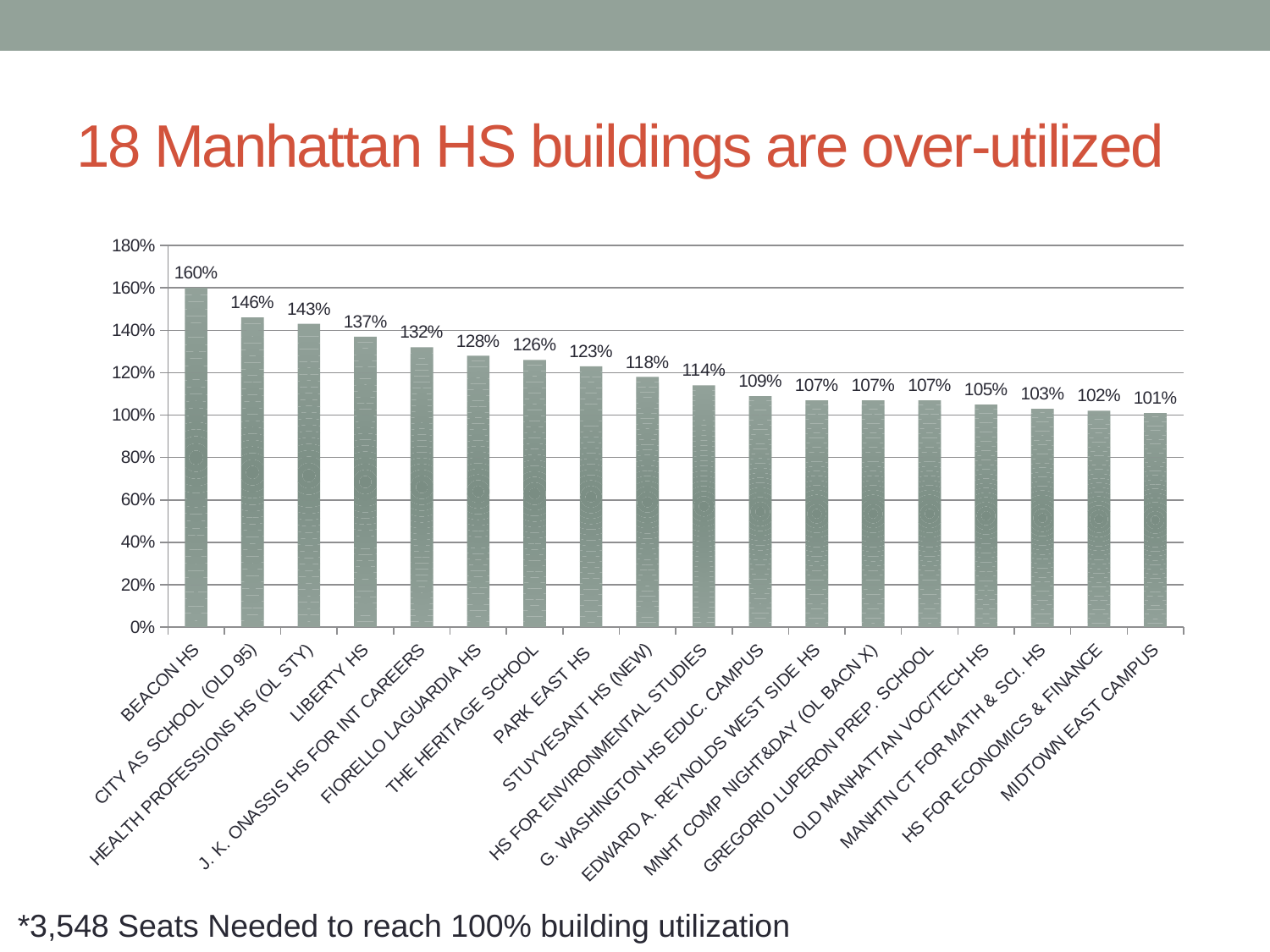
What is the utilization value shown for STUYVESANT HS (NEW)? 118% Which has a higher utilization, HEALTH PROFESSIONS HS (OL STY) or THE HERITAGE SCHOOL? HEALTH PROFESSIONS HS (OL STY) What is the difference between the utilization of LIBERTY HS and PARK EAST HS? 14% What is the utilization value shown for FIORELLO LAGUARDIA HS? 128% What is the utilization value shown for BEACON HS? 160% Is the value for HS FOR ENVIRONMENTAL STUDIES greater or less than 120%? less How many buildings are shown in the chart? 18 What is the difference between the utilization of BEACON HS and CITY AS SCHOOL (OLD 95)? 14% What type of chart is shown on the slide? Bar chart Which building has the lowest utilization in the chart? MIDTOWN EAST CAMPUS Which building has the highest utilization in the chart? BEACON HS Do the values rise or fall moving from left to right along the x axis? Fall